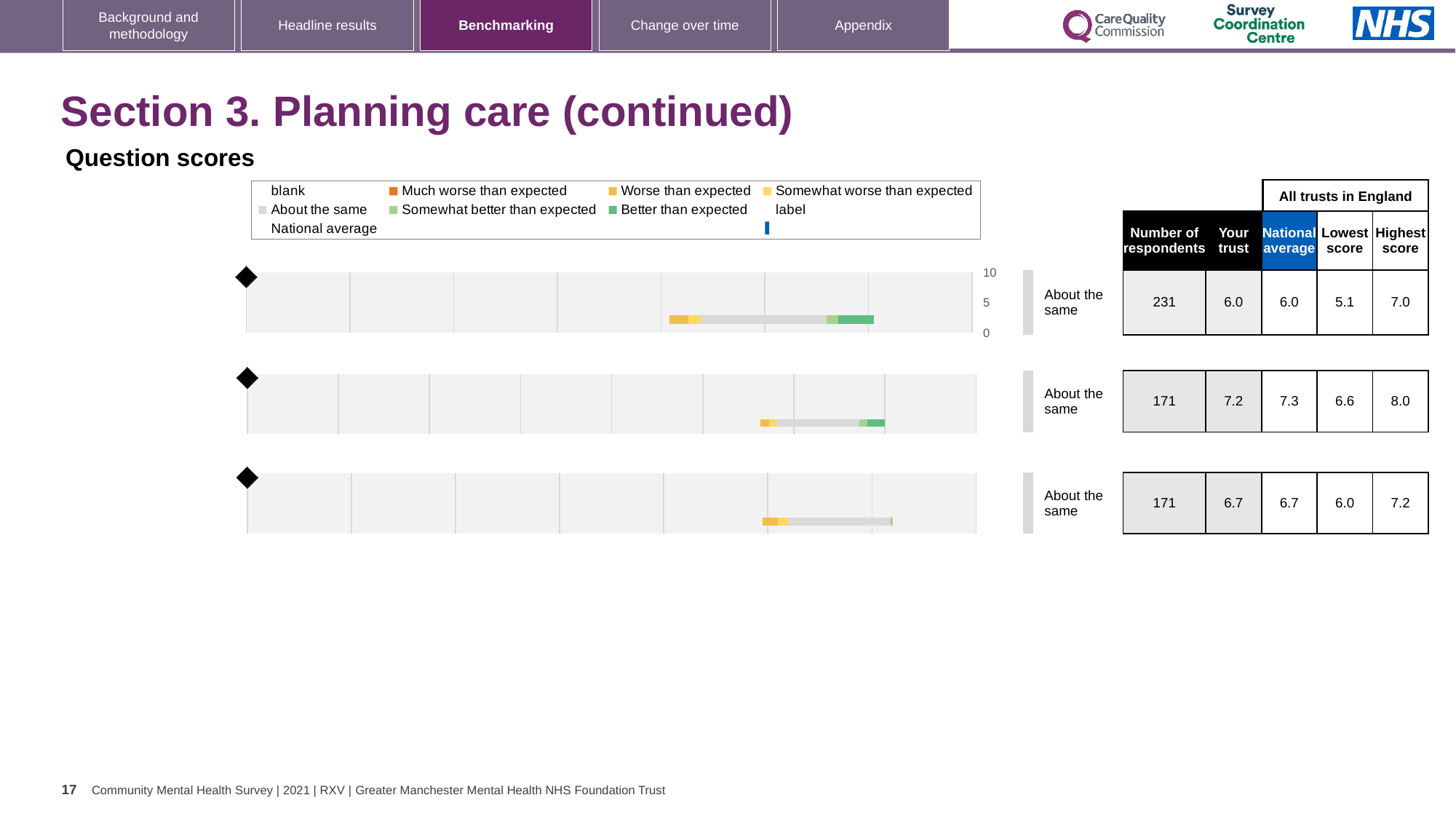
What kind of chart is used for the three benchmarking charts on this slide? bar chart For the bottom chart, what is the highest score across all trusts in England? 7.2 For the middle chart, what is the 'Your trust' score in the table? 7.2 What is the maximum value shown on the vertical axis of the top chart? 10 How many benchmarking charts are shown on the slide? 3 For the top chart, is the 'Your trust' score greater or less than 5? greater What benchmark category is shown next to the top chart? About the same For the middle chart, which is larger: the 'Your trust' score or the national average? National average Which chart (top, middle or bottom) has the highest 'Your trust' score? middle For the top chart, what is the difference between the highest score and the lowest score? 1.9 For the top chart, how many respondents are listed in the table? 231